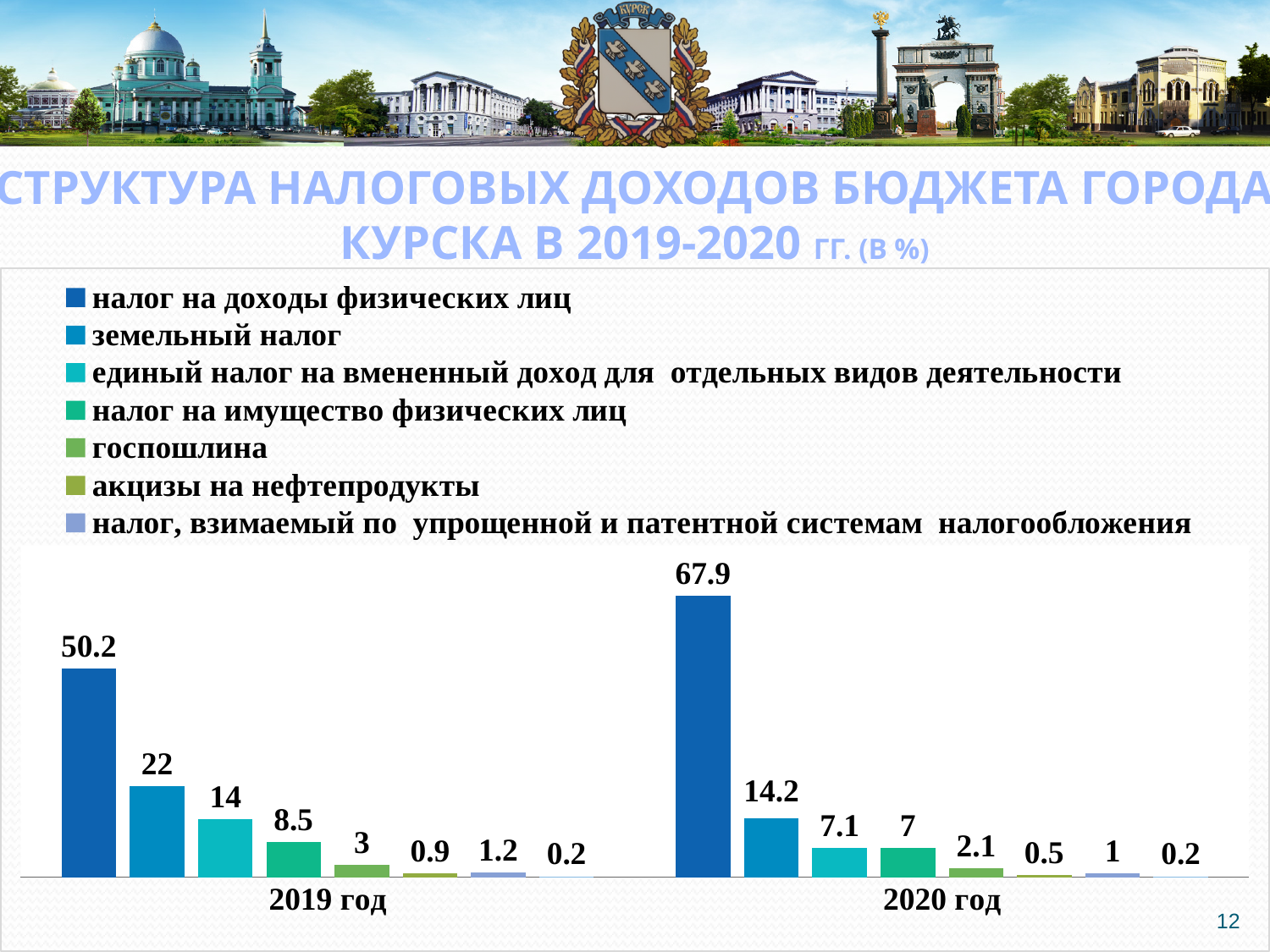
What is the value for земельный налог in 2020 год? 14.2 Which is larger: налог на имущество физических лиц in 2019 год or in 2020 год? 2019 год What is the value for единый налог на вмененный доход для отдельных видов деятельности in 2019 год? 14 How many year categories are shown on the x axis? 2 What is the value for налог на доходы физических лиц in 2020 год? 67.9 Which series has the highest value in 2020 год? налог на доходы физических лиц What type of chart is shown on the slide? bar chart How many series does the legend list? 7 What is the difference between земельный налог in 2019 год and in 2020 год? 7.8 What is the value for налог на доходы физических лиц in 2019 год? 50.2 By how much did the value for налог на доходы физических лиц change from 2019 год to 2020 год? 17.7 What is the value for госпошлина in 2020 год? 2.1